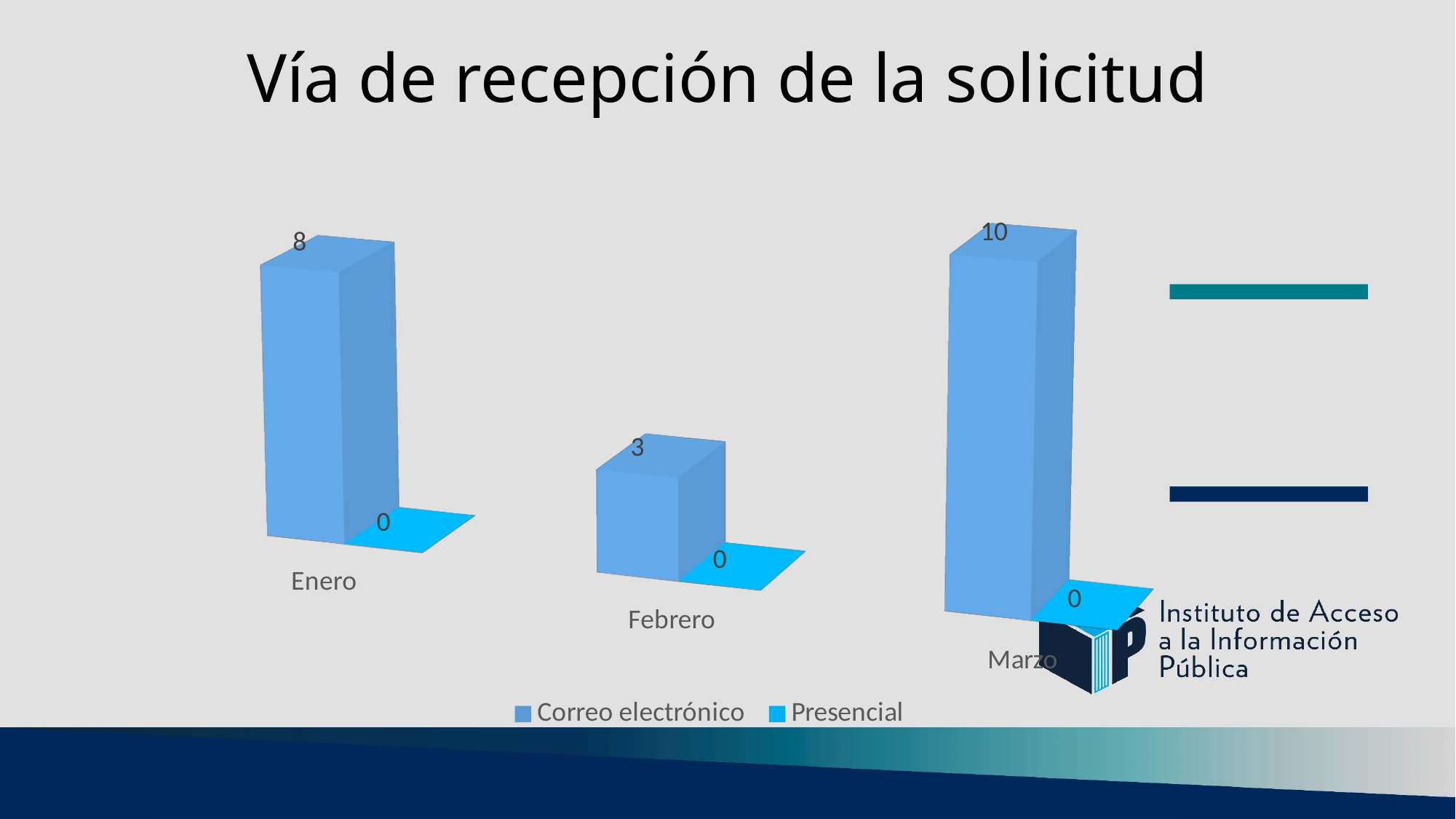
How many series does the legend list? 2 What kind of chart is shown on the slide? Bar chart Which is larger, the Correo electrónico value for Enero or for Febrero? Enero What is the value for Presencial in Marzo? 0 How many months are shown on the x axis? 3 What is the value for Correo electrónico in Enero? 8 What is the difference between the Correo electrónico values for Marzo and Enero? 2 Which month has the lowest value for Correo electrónico? Febrero Which month has the highest value for Correo electrónico? Marzo What is the value for Correo electrónico in Febrero? 3 What is the value for Correo electrónico in Marzo? 10 What is the title of the chart? Vía de recepción de la solicitud